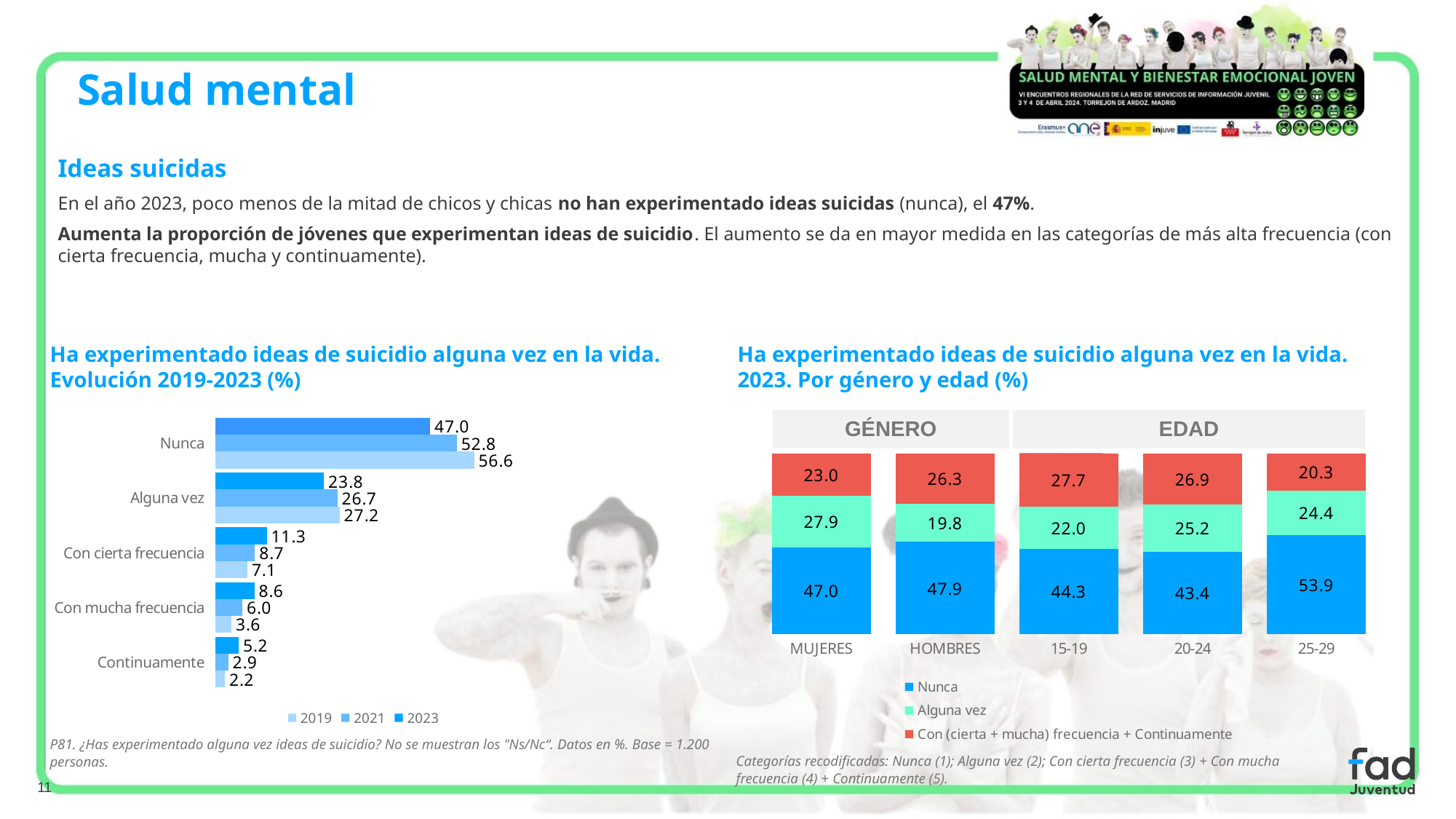
In the right chart (2023. Por género y edad), which series is shown in red? Con (cierta + mucha) frecuencia + Continuamente In the left chart (Evolución 2019-2023), what is the value for Nunca in 2023? 47.0 In the left chart (Evolución 2019-2023), how many categories are shown? 5 In the left chart (Evolución 2019-2023), does the value for Continuamente rise or fall from 2019 to 2023? rise In the left chart (Evolución 2019-2023), what is the difference between the Nunca values for 2019 and 2023? 9.6 In the right chart (2023. Por género y edad), which category has the highest Nunca value? 25-29 What kind of chart is the left chart (Evolución 2019-2023)? bar chart In the right chart (2023. Por género y edad), what is the Nunca value for 25-29? 53.9 In the right chart (2023. Por género y edad), what is the total of the stacked bar for 15-19? 94.0 In the right chart (2023. Por género y edad), which is larger, the Alguna vez value for MUJERES or for HOMBRES? MUJERES In the left chart (Evolución 2019-2023), what is the value for Con cierta frecuencia in 2019? 7.1 In the left chart (Evolución 2019-2023), how many series does the legend list? 3